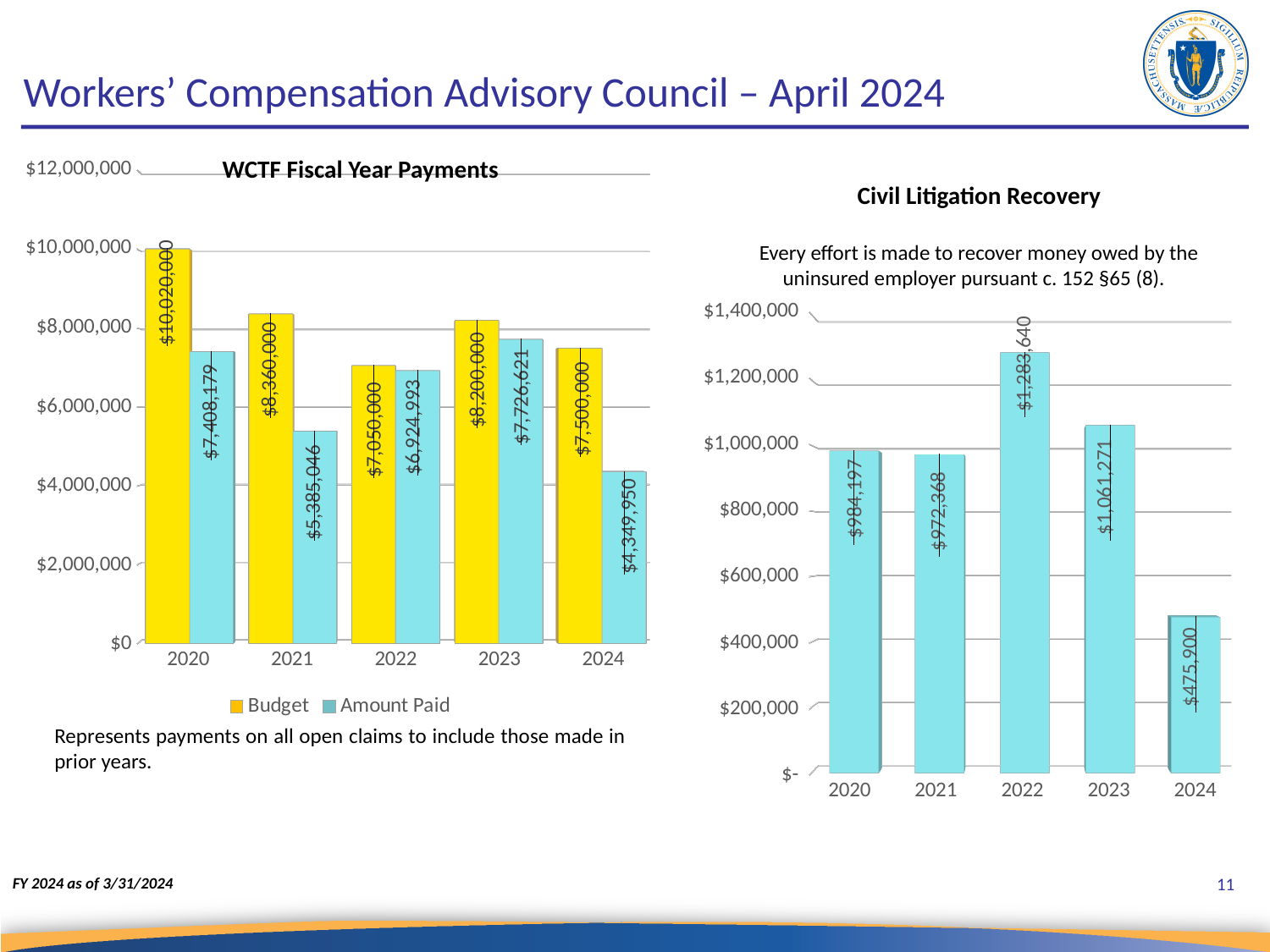
In the WCTF Fiscal Year Payments chart, what is the difference between the Budget and the Amount Paid for 2021? $2,974,954 How many series does the legend of the WCTF Fiscal Year Payments chart list? 2 In the WCTF Fiscal Year Payments chart, which colour represents the Budget series? Yellow In the WCTF Fiscal Year Payments chart, what was the Budget for 2020? $10,020,000 In the WCTF Fiscal Year Payments chart, which year had the lowest Amount Paid? 2024 In the WCTF Fiscal Year Payments chart, which is larger: the Amount Paid in 2022 or the Amount Paid in 2021? Amount Paid in 2022 What kind of chart is the WCTF Fiscal Year Payments chart? Bar chart How many years are shown on the x axis of the Civil Litigation Recovery chart? 5 In the Civil Litigation Recovery chart, what is the difference between the 2023 and 2024 values? $585,371 In the Civil Litigation Recovery chart, what was the value for 2022? $1,283,640 In the WCTF Fiscal Year Payments chart, what was the Amount Paid in 2023? $7,726,621 In the Civil Litigation Recovery chart, which year had the highest value? 2022